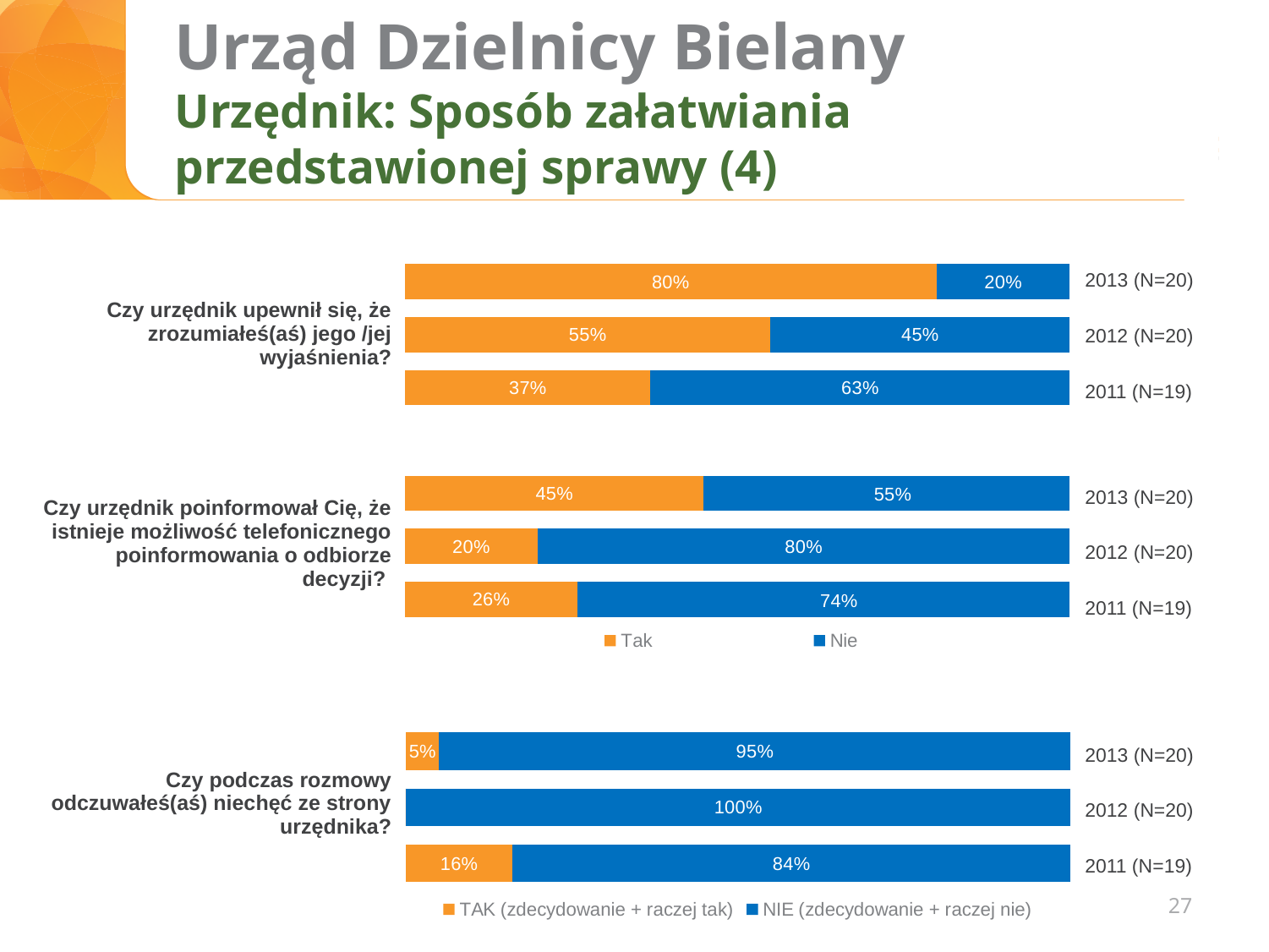
In the bottom chart (Czy podczas rozmowy odczuwałeś(aś) niechęć...), what is the total of the 2013 (N=20) bar? 100% What kind of chart is used for the three charts on this slide? Stacked bar chart In the top chart (Czy urzędnik upewnił się, że zrozumiałeś(aś) jego/jej wyjaśnienia?), what is the 'Tak' value for 2013 (N=20)? 80% In the top chart (Czy urzędnik upewnił się...), what is the difference between the 'Tak' values for 2013 and 2012? 25 percentage points In the middle chart (Czy urzędnik poinformował Cię...), is the 'Tak' value for 2013 larger or smaller than the 'Tak' value for 2011? larger In the middle chart (Czy urzędnik poinformował Cię...), which year has the lowest 'Tak' share? 2012 (N=20) In the bottom chart (Czy podczas rozmowy odczuwałeś(aś) niechęć...), what is the 'TAK' value for 2011 (N=19)? 16% In the bottom chart (Czy podczas rozmowy odczuwałeś(aś) niechęć ze strony urzędnika?), what is the 'NIE' value for 2012 (N=20)? 100% How many series does the legend of the bottom chart list? 2 In the middle chart (Czy urzędnik poinformował Cię, że istnieje możliwość telefonicznego poinformowania o odbiorze decyzji?), what is the 'Nie' value for 2012 (N=20)? 80% In the top chart (Czy urzędnik upewnił się...), which year has the highest 'Tak' share? 2013 (N=20) In the top chart (Czy urzędnik upewnił się...), what is the 'Nie' value for 2011 (N=19)? 63%